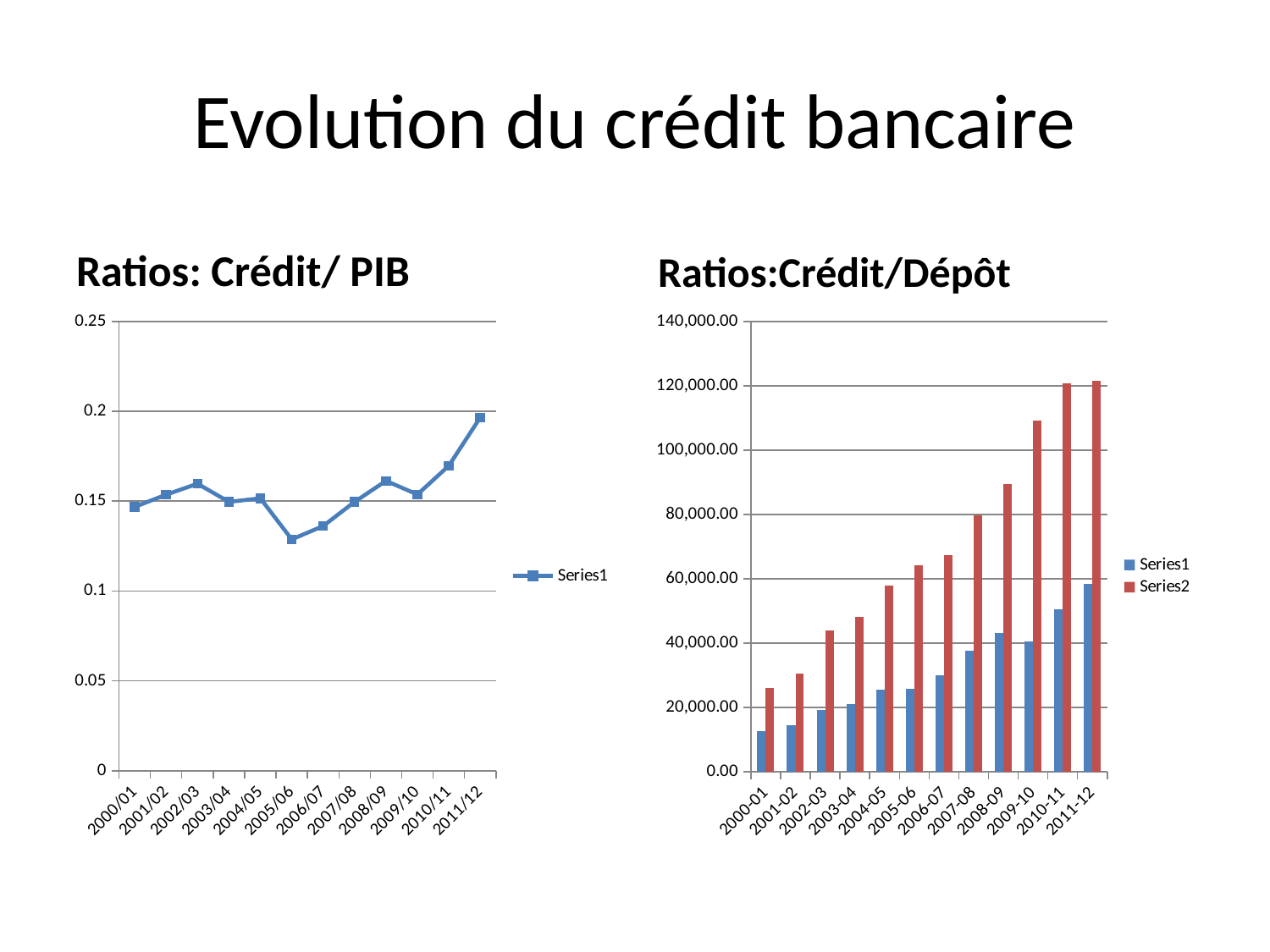
On the 'Ratios: Crédit/ PIB' chart, is the value for 2005/06 greater or less than 0.15? less What kind of chart is the 'Ratios: Crédit/ PIB' chart on the left? line chart On the 'Ratios: Crédit/ PIB' chart, which year has the highest value? 2011/12 How many series does the legend of the 'Ratios:Crédit/Dépôt' chart list? 2 On the 'Ratios:Crédit/Dépôt' chart, is the Series2 value for 2009-10 greater or less than 100,000.00? greater On the 'Ratios: Crédit/ PIB' chart, which year has the lowest value? 2005/06 How many data points are plotted on the 'Ratios: Crédit/ PIB' chart? 12 On the 'Ratios:Crédit/Dépôt' chart, which category has the lowest Series1 value? 2000-01 What kind of chart is the 'Ratios:Crédit/Dépôt' chart on the right? bar chart On the 'Ratios: Crédit/ PIB' chart, is the value for 2010/11 greater or less than 0.15? greater On the 'Ratios:Crédit/Dépôt' chart, which category has the highest Series2 value? 2011-12 On the 'Ratios:Crédit/Dépôt' chart, do the Series2 values rise or fall from 2000-01 to 2011-12? rise